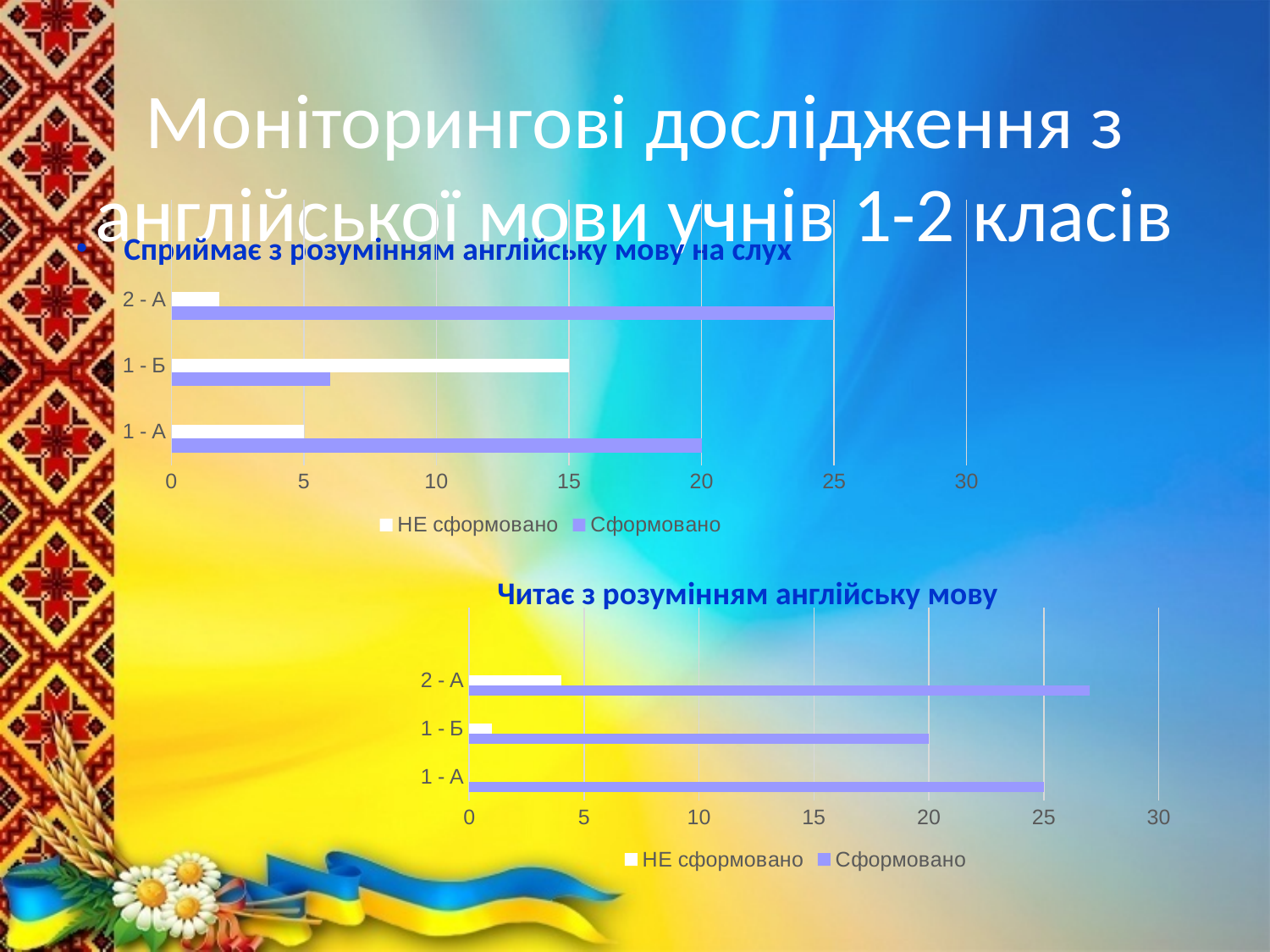
In the top chart 'Сприймає з розумінням англійську мову на слух', which category has the highest 'Сформовано' value? 2 - А In the top chart 'Сприймає з розумінням англійську мову на слух', what is the 'НЕ сформовано' value for 1 - Б? 15 In the bottom chart 'Читає з розумінням англійську мову', is the 'Сформовано' value for 2 - А greater or less than 25? greater In the top chart 'Сприймає з розумінням англійську мову на слух', is the 'Сформовано' value for 1 - Б greater or less than 10? less How many categories does the top chart 'Сприймає з розумінням англійську мову на слух' show? 3 In the bottom chart 'Читає з розумінням англійську мову', what is the 'Сформовано' value for 1 - Б? 20 In the bottom chart 'Читає з розумінням англійську мову', what is the 'Сформовано' value for 1 - А? 25 In the top chart 'Сприймає з розумінням англійську мову на слух', what is the 'Сформовано' value for 1 - А? 20 In the top chart 'Сприймає з розумінням англійську мову на слух', what is the 'Сформовано' value for 2 - А? 25 In the bottom chart 'Читає з розумінням англійську мову', which category has the lowest 'Сформовано' value? 1 - Б How many series does the legend of the bottom chart 'Читає з розумінням англійську мову' list? 2 What kind of chart is the top chart, 'Сприймає з розумінням англійську мову на слух'? bar chart